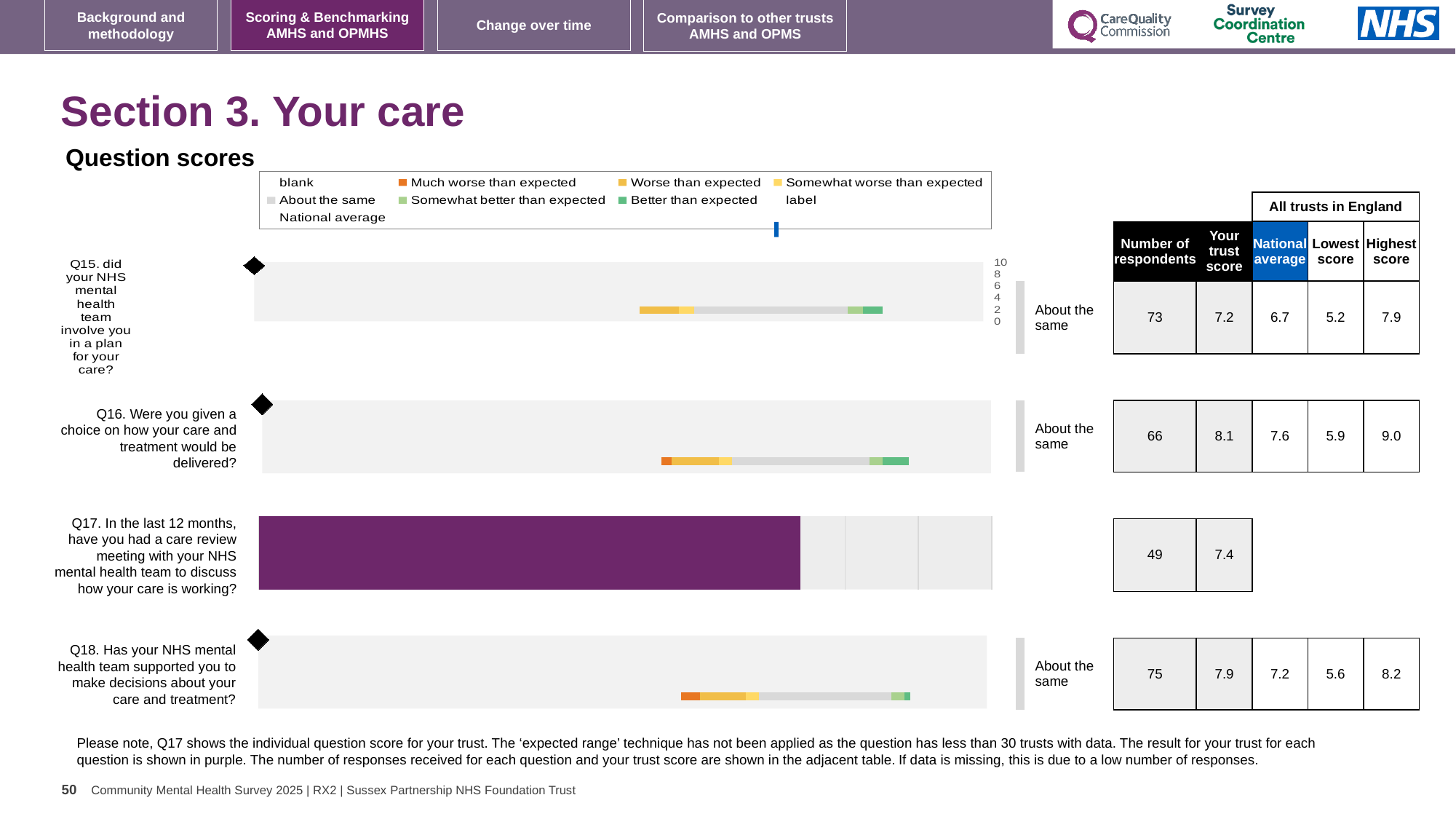
What kind of chart is used to show the question scores? bar chart What is the difference between the trust score and the national average for Q16? 0.5 Which question has the highest trust score? Q16 Is the trust score for Q18 higher or lower than the national average for Q18? higher How many respondents answered Q18 (Has your NHS mental health team supported you to make decisions about your care and treatment)? 75 What is the highest score among all trusts in England for Q16? 9.0 What is the trust score for Q16 (Were you given a choice on how your care and treatment would be delivered)? 8.1 What is the lowest score among all trusts in England for Q18? 5.6 Which question has the lowest number of respondents? Q17 What benchmark label is shown next to the bars for Q15, Q16 and Q18? About the same How many questions are plotted in the Question scores chart? 4 What is the national average score for Q15 (did your NHS mental health team involve you in a plan for your care)? 6.7